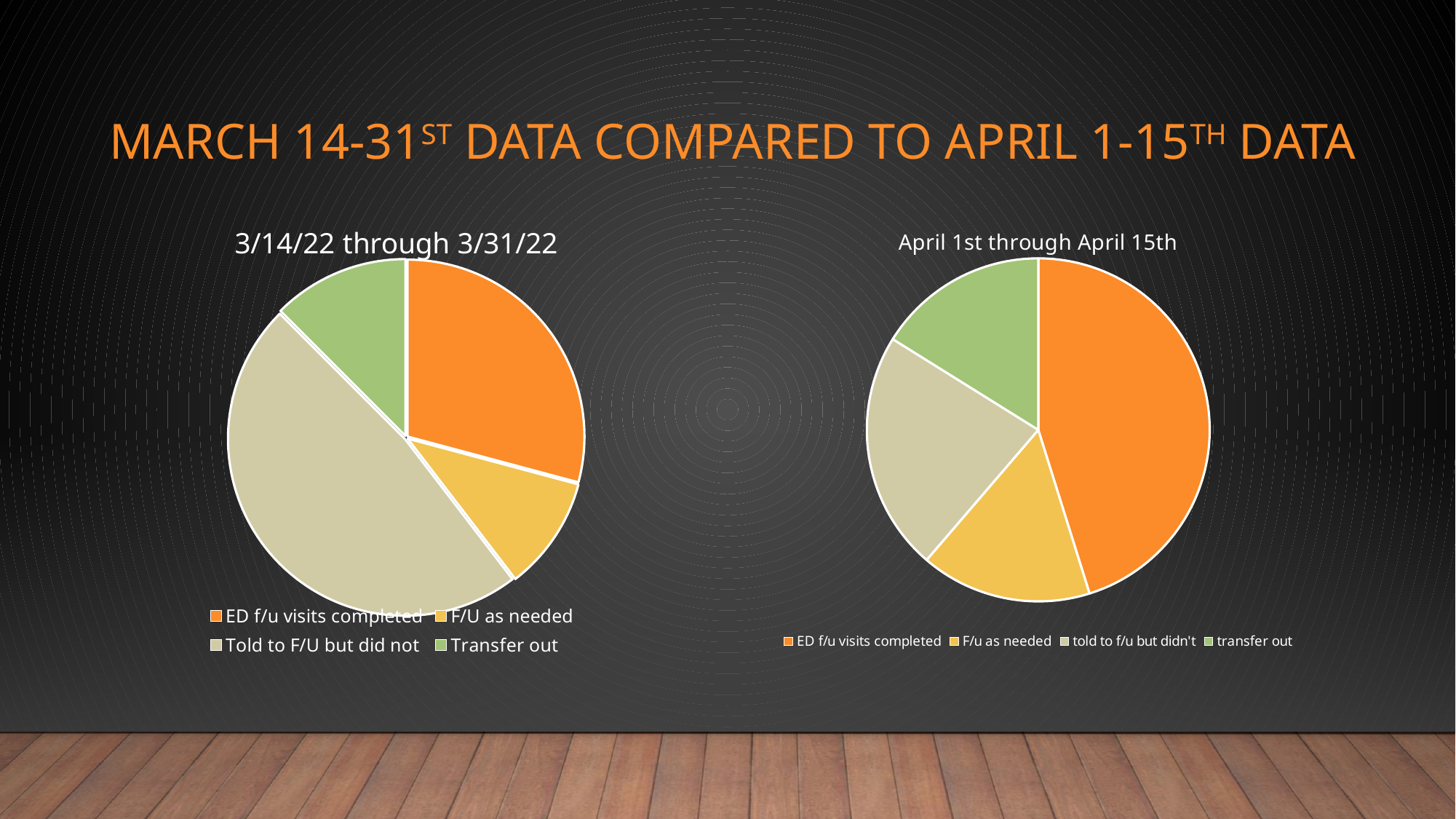
In the chart titled "3/14/22 through 3/31/22", how many slices does the pie have? 4 What is the title of the pie chart on the right side of the slide? April 1st through April 15th In the chart titled "April 1st through April 15th", which category has the largest slice? ED f/u visits completed In the chart titled "April 1st through April 15th", how many categories does the legend list? 4 In the chart titled "April 1st through April 15th", which slice is larger: "ED f/u visits completed" or "told to f/u but didn't"? ED f/u visits completed In the chart titled "3/14/22 through 3/31/22", what colour is the "Transfer out" slice? green In the chart titled "3/14/22 through 3/31/22", which slice is larger: "ED f/u visits completed" or "Told to F/U but did not"? Told to F/U but did not In the chart titled "April 1st through April 15th", which slice is larger: "told to f/u but didn't" or "F/u as needed"? told to f/u but didn't What kind of chart is the chart titled "3/14/22 through 3/31/22"? pie chart In the chart titled "3/14/22 through 3/31/22", which category has the smallest slice? F/U as needed What kind of chart is the chart titled "April 1st through April 15th"? pie chart In the chart titled "3/14/22 through 3/31/22", which category has the largest slice? Told to F/U but did not